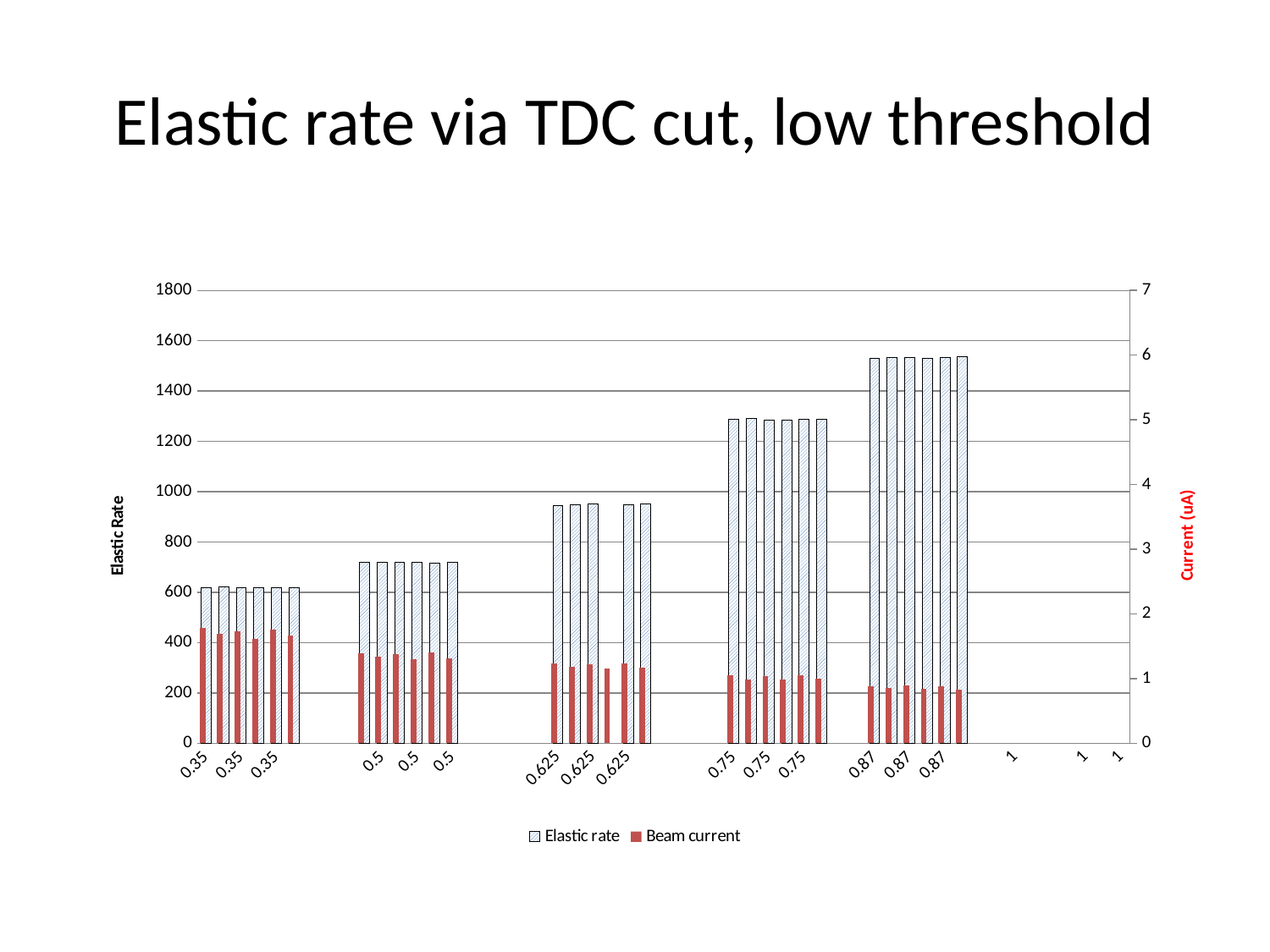
Is the Elastic rate at x = 0.625 greater or less than 1000? less How many series does the legend list? 2 Is the Elastic rate at x = 0.75 greater or less than 1200? greater Is the Elastic rate at x = 0.87 greater or less than 1400? greater What is the title of the right-hand vertical axis? Current (uA) What kind of chart is shown on the slide? bar chart Which has the larger Beam current, the group at x = 0.35 or the group at x = 0.87? 0.35 At which x-axis value is the Elastic rate highest? 0.87 What are the two series named in the legend? Elastic rate and Beam current Among the groups with bars, at which x-axis value is the Elastic rate lowest? 0.35 Does the Elastic rate rise or fall as the x-axis value increases from 0.35 to 0.87? rise